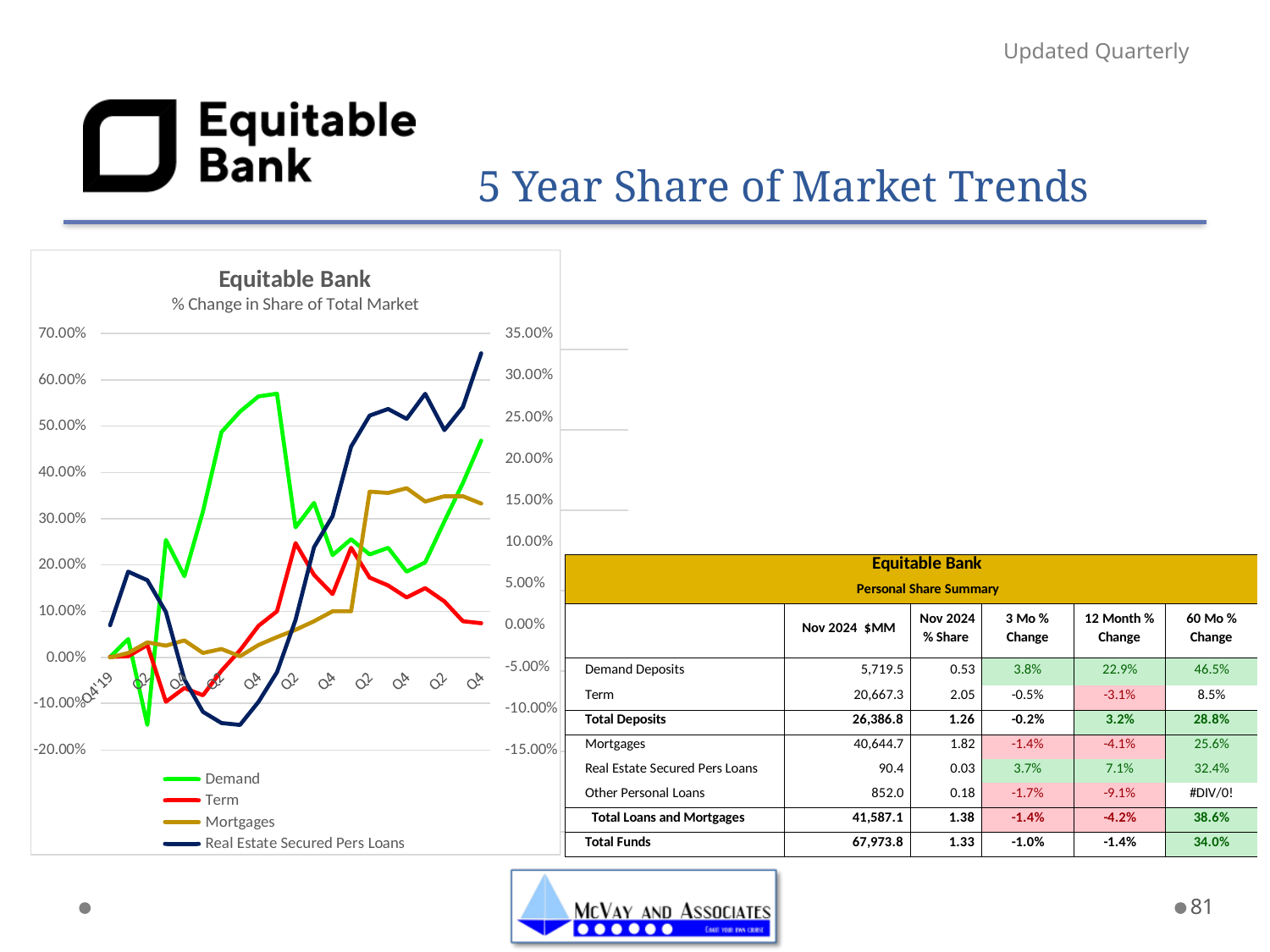
Which series is plotted highest at the final point of the line chart? Real Estate Secured Pers Loans What is the highest tick value shown on the left vertical axis of the line chart? 70.00% At the final point of the line chart, which line is plotted lower, Term or Mortgages? Term What is the first label on the x axis of the line chart? Q4'19 What is the lowest tick value shown on the right vertical axis of the line chart? -15.00% What is the title of the line chart? Equitable Bank % Change in Share of Total Market What kind of chart is shown on the slide? Line chart Which series in the line chart is drawn in green? Demand Does the Real Estate Secured Pers Loans line rise or fall overall from the first to the last point? Rises How many series does the legend of the line chart list? 4 Does the Mortgages line rise or fall overall from the first to the last point? Rises At the final point of the line chart, which line is plotted higher, Demand or Term? Demand